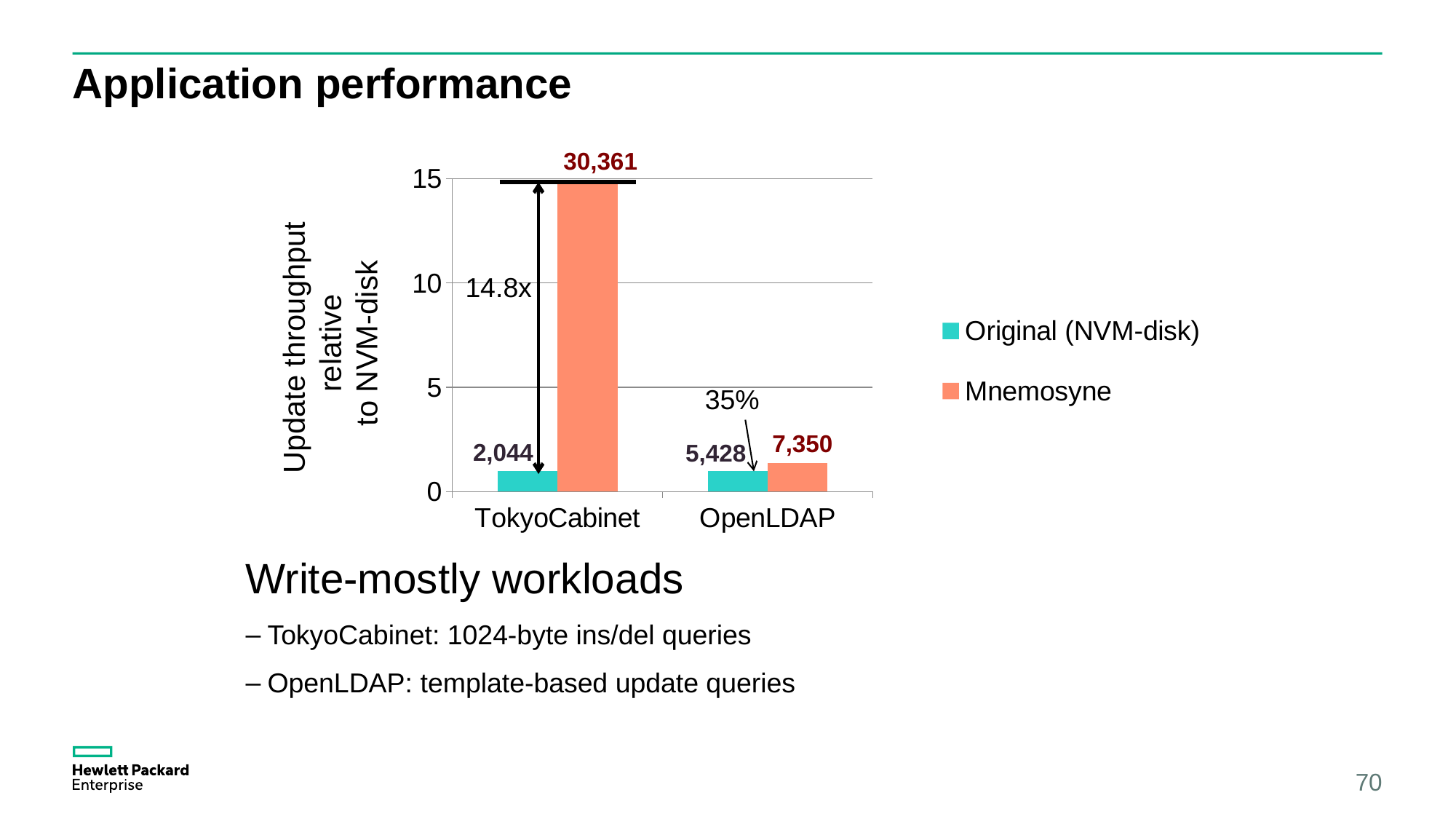
What is the data label on the Original (NVM-disk) bar for OpenLDAP? 5,428 What is the data label on the Original (NVM-disk) bar for TokyoCabinet? 2,044 How many series does the legend list? 2 How many categories are shown on the x axis? 2 What kind of chart is shown on the slide? bar chart What is the data label on the Mnemosyne bar for OpenLDAP? 7,350 What speedup is annotated on the arrow for TokyoCabinet? 14.8x Which bar has the highest labelled value? Mnemosyne for TokyoCabinet What is the difference between the Mnemosyne and Original (NVM-disk) labels for TokyoCabinet? 28,317 Is the Mnemosyne bar for TokyoCabinet greater or less than 10 on the relative throughput axis? greater What is the data label on the Mnemosyne bar for TokyoCabinet? 30,361 Is the Mnemosyne bar for OpenLDAP greater or less than 5 on the relative throughput axis? less